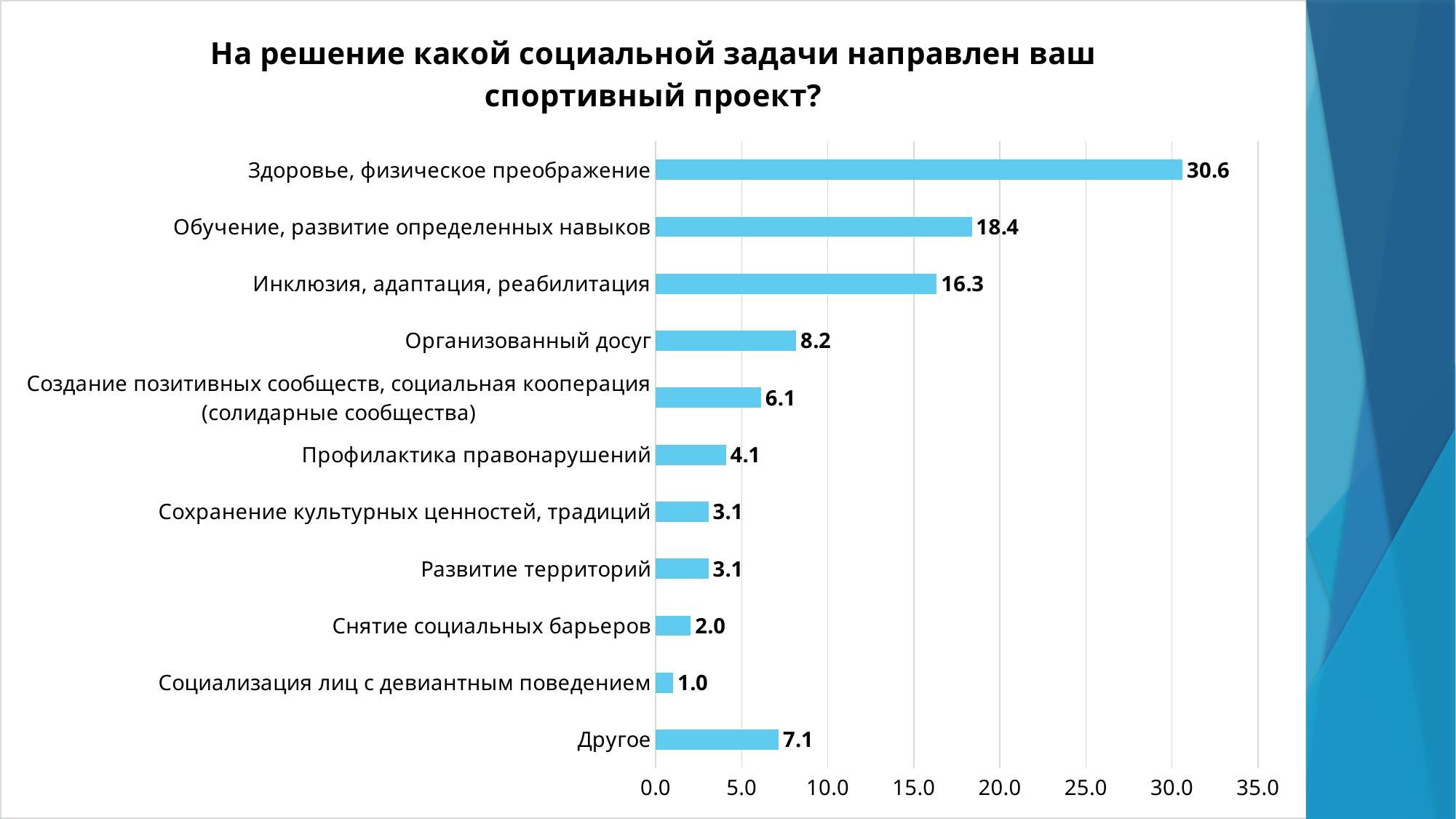
What is the value for «Здоровье, физическое преображение»? 30.6 What is the value for «Другое»? 7.1 What is the title of the chart? На решение какой социальной задачи направлен ваш спортивный проект? What is the difference between the values for «Здоровье, физическое преображение» and «Обучение, развитие определенных навыков»? 12.2 Is the value for «Обучение, развитие определенных навыков» greater or less than 15.0? greater Which category has the lowest value? Социализация лиц с девиантным поведением Which is larger: the value for «Организованный досуг» or the value for «Другое»? Организованный досуг Which category has the highest value? Здоровье, физическое преображение How many categories are shown in the chart? 11 What kind of chart is shown on the slide? bar chart What is the difference between the values for «Обучение, развитие определенных навыков» and «Инклюзия, адаптация, реабилитация»? 2.1 What is the value for «Инклюзия, адаптация, реабилитация»? 16.3